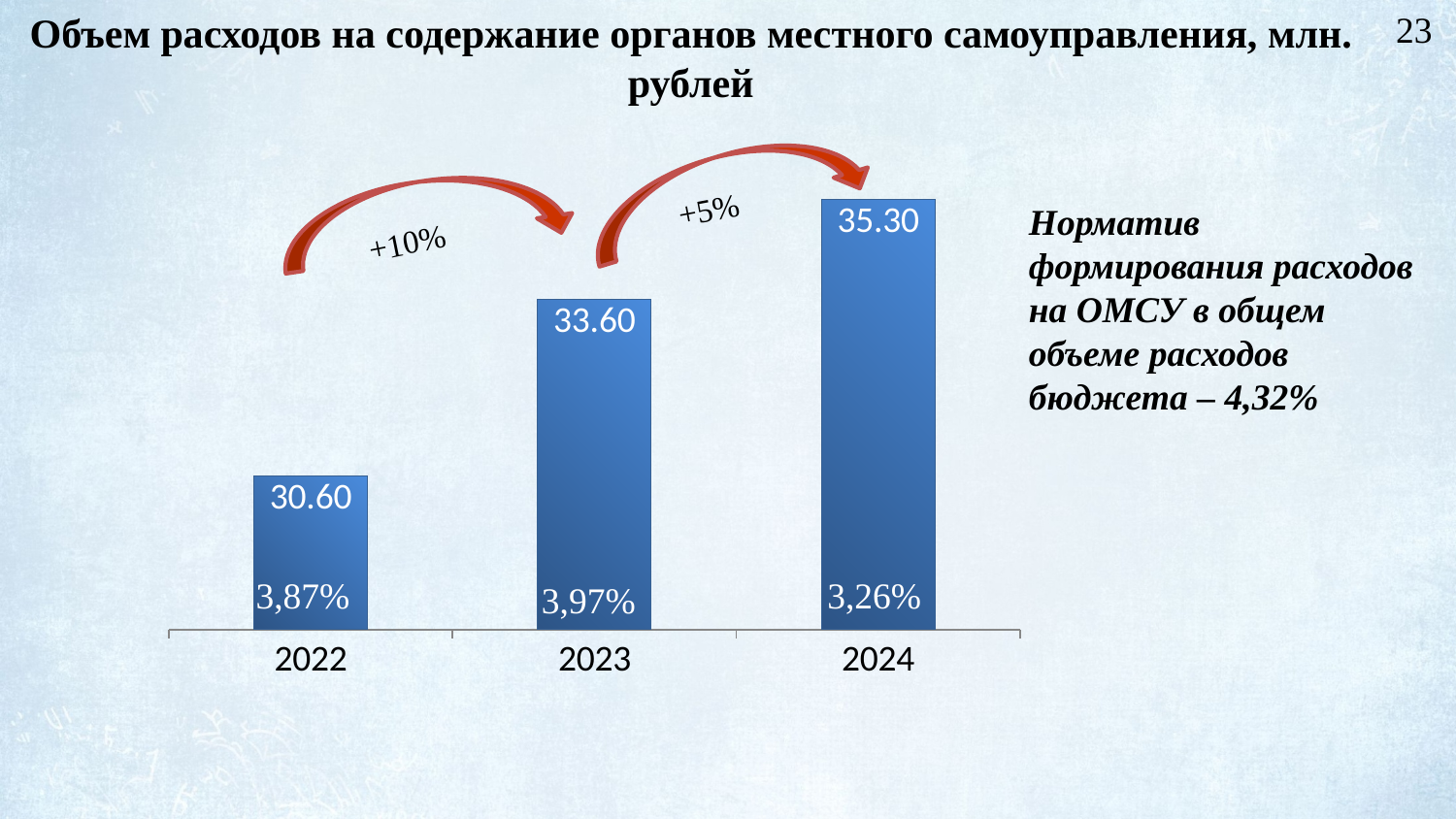
What is the difference between the values for 2024 and 2022? 4.70 What is the value for 2022? 30.60 What is the difference between the values for 2023 and 2022? 3.00 Which year has the lowest value? 2022 What kind of chart is this? bar chart Do the values rise or fall from 2022 to 2024? rise What percentage label is shown at the bottom of the 2023 bar? 3,97% How many years are shown on the chart? 3 Which is larger, the value for 2023 or the value for 2024? 2024 What is the value for 2024? 35.30 What is the value for 2023? 33.60 Which year has the highest value? 2024